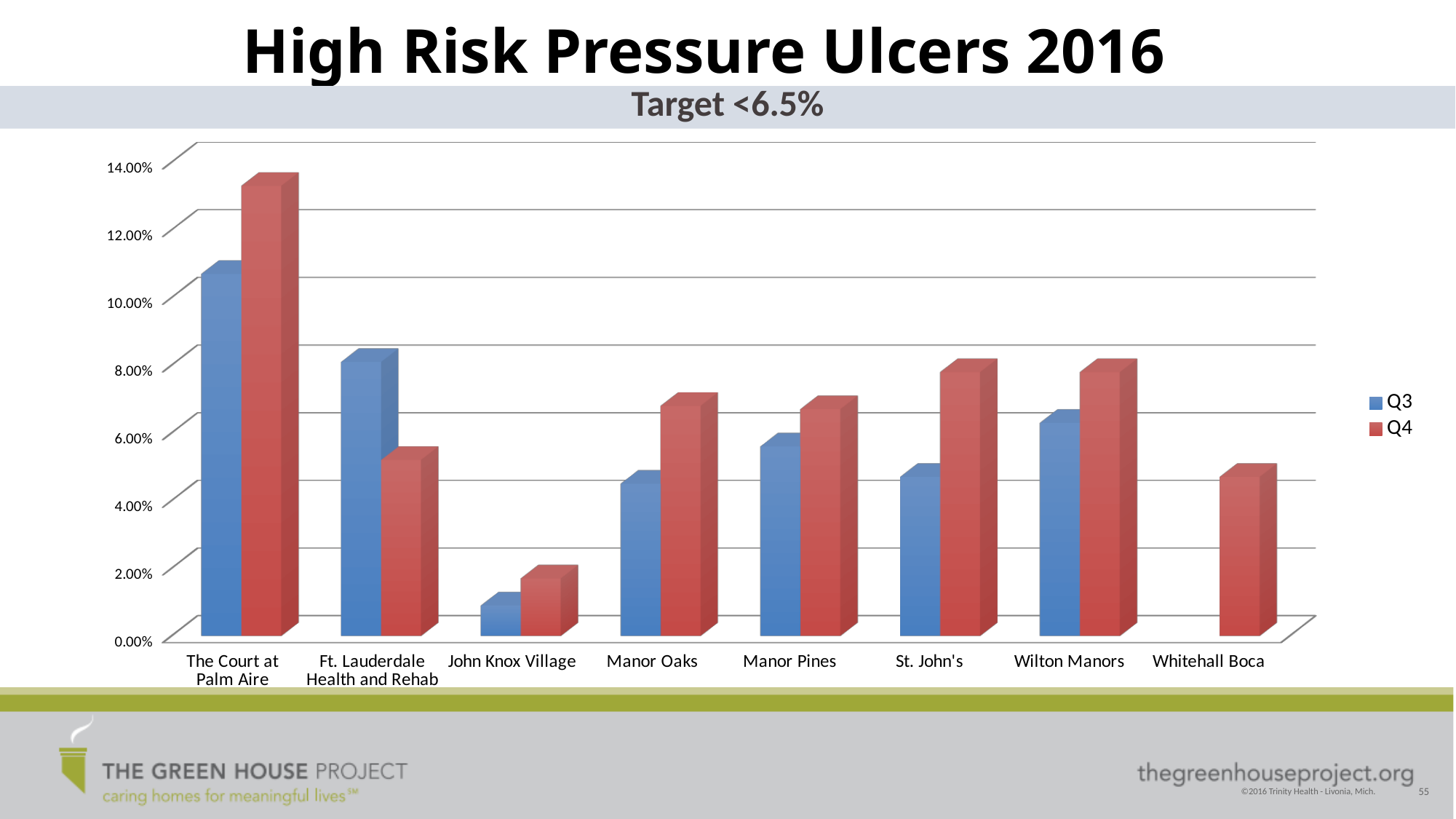
For Ft. Lauderdale Health and Rehab, which is larger, the Q3 value or the Q4 value? Q3 Which facility has the highest Q4 value? The Court at Palm Aire How many series does the legend list? 2 Is the Q4 value for The Court at Palm Aire greater or less than 12.00%? greater For Manor Oaks, which is larger, the Q3 value or the Q4 value? Q4 Which facility has only a Q4 bar and no Q3 bar? Whitehall Boca Which facility has the lowest Q3 value? John Knox Village What kind of chart is shown on the slide? bar chart Is the Q4 value for John Knox Village greater or less than 4.00%? less What target is stated below the chart title? Target <6.5% How many facilities are shown along the x axis? 8 Is the Q3 value for Ft. Lauderdale Health and Rehab greater or less than 6.00%? greater